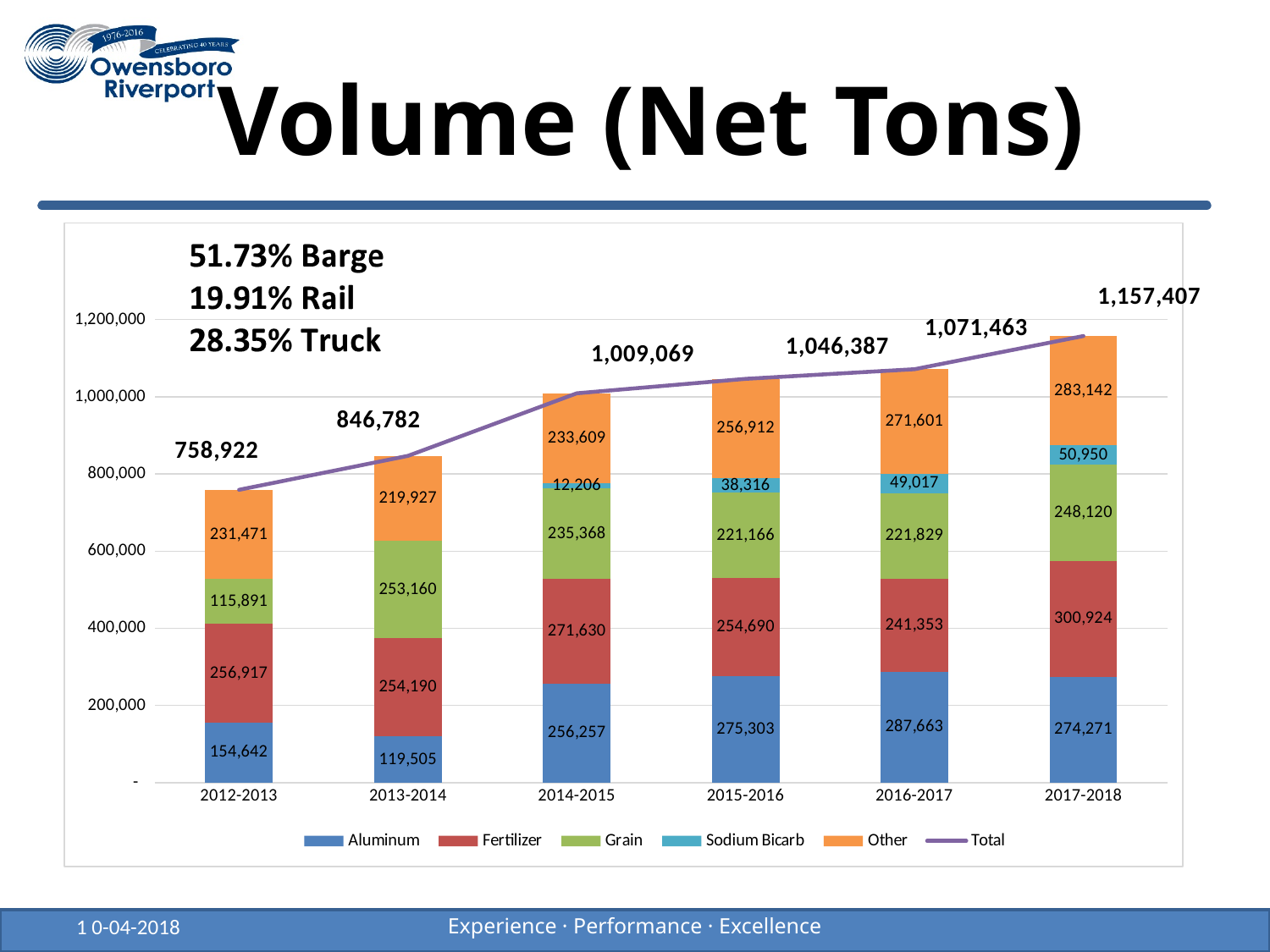
What is the Other volume for 2017-2018? 283,142 What is the Aluminum volume for 2016-2017? 287,663 Which year has the highest total volume? 2017-2018 Which year has the larger Aluminum volume, 2012-2013 or 2013-2014? 2012-2013 How many years are shown on the x axis? 6 How many series does the legend list? 6 Which year has the lowest total volume? 2012-2013 What kind of chart is shown on the slide? Stacked bar chart with a line for Total What is the difference between the total volume in 2017-2018 and in 2012-2013? 398,485 What is the Sodium Bicarb volume for 2015-2016? 38,316 Does the total volume rise or fall from 2012-2013 to 2017-2018? Rises By how much did the Fertilizer volume increase from 2016-2017 to 2017-2018? 59,571